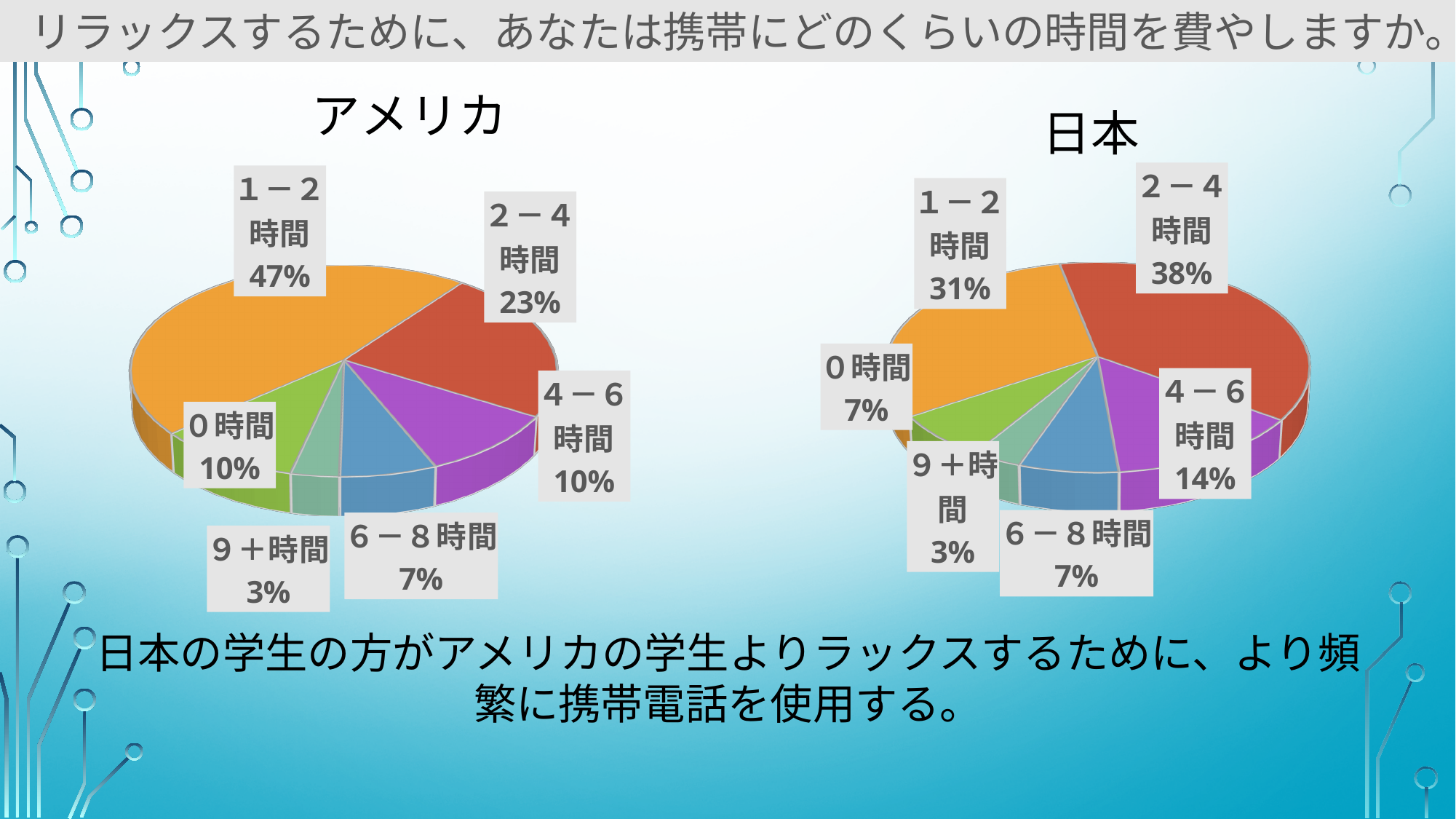
In the アメリカ pie chart, what is the combined share of 0時間 and 4－6時間? 20% In the アメリカ pie chart, what share is labelled for 1－2時間? 47% In the 日本 pie chart, which category has the largest share? 2－4時間 What colour is the 1－2時間 slice in both pie charts? Orange In the アメリカ pie chart, which category has the largest share? 1－2時間 In the 日本 pie chart, what share is labelled for 2－4時間? 38% What is the difference between the 2－4時間 share in the 日本 chart and the 2－4時間 share in the アメリカ chart? 15% Which chart shows a larger share for 4－6時間, アメリカ or 日本? 日本 What kind of chart is used for the アメリカ (America) data? Pie chart In the 日本 pie chart, what share is labelled for 0時間? 7% How many categories (slices) does the アメリカ pie chart have? 6 In the アメリカ pie chart, which category has the smallest share? 9＋時間